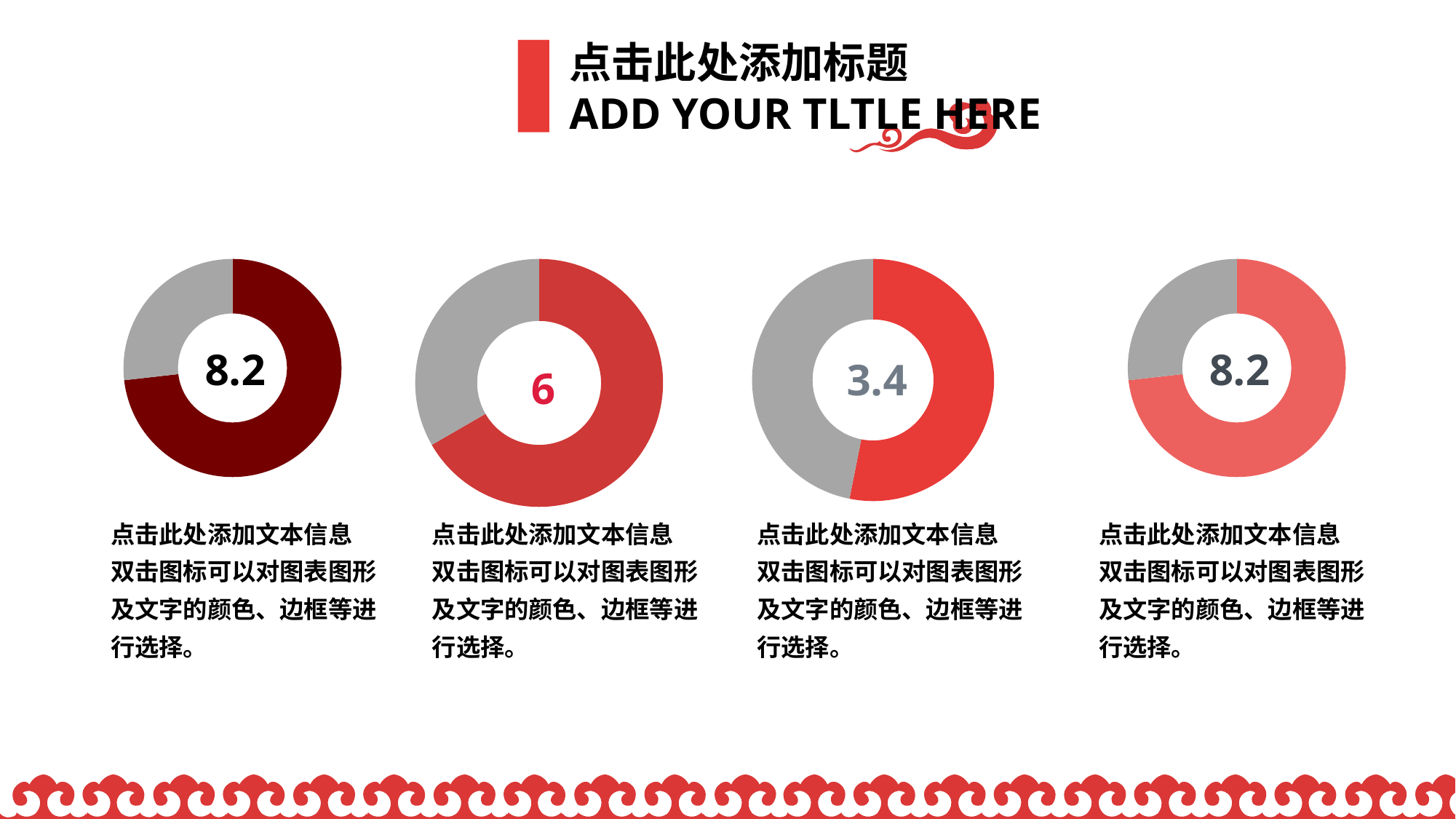
What kind of chart is used for the four figures on the slide? Donut (pie) chart In the leftmost donut chart, which segment is larger, the dark red one or the grey one? The dark red one How many donut charts are on the slide? 4 What value is shown in the centre of the rightmost donut chart? 8.2 What colour is the centre number in the second donut chart from the left? Red What value is shown in the centre of the third donut chart from the left? 3.4 What is the difference between the centre value of the rightmost donut chart and the second donut chart? 2.2 What value is shown in the centre of the second donut chart from the left? 6 What is the difference between the centre value of the leftmost donut chart and the third donut chart? 4.8 What value is shown in the centre of the leftmost donut chart? 8.2 Which donut chart shows the smallest centre value? The third from the left (3.4) Which is larger, the centre value of the second donut chart or the third donut chart? The second (6)